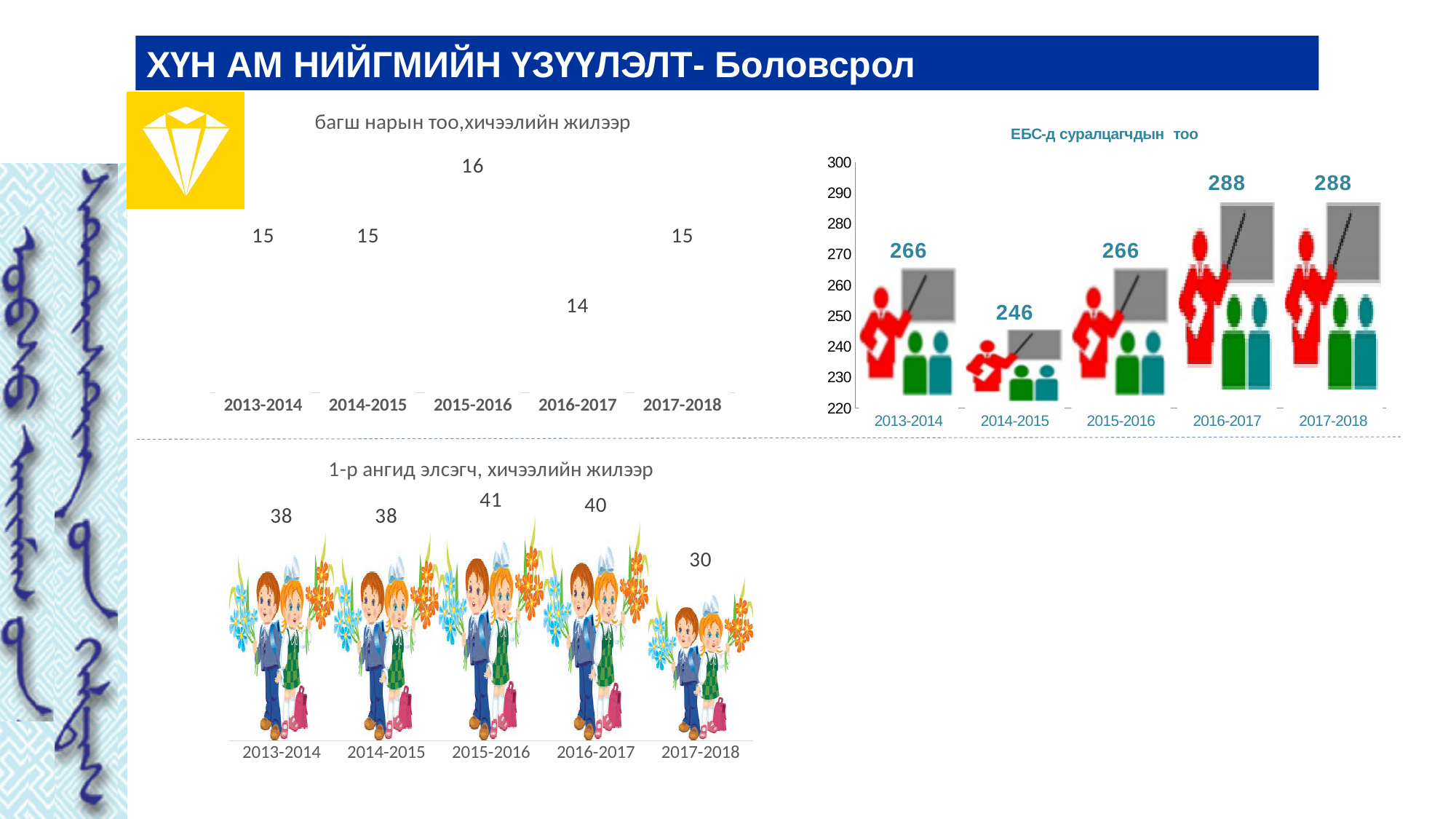
In the chart titled "багш нарын тоо,хичээлийн жилээр", what is the value for 2015-2016? 16 In the chart titled "ЕБС-д суралцагчдын тоо", is the value for 2015-2016 greater or less than 250? greater In the chart titled "ЕБС-д суралцагчдын тоо", how many school years are shown on the x axis? 5 In the chart titled "1-р ангид элсэгч, хичээлийн жилээр", which is larger, the value for 2016-2017 or the value for 2017-2018? 2016-2017 In the chart titled "ЕБС-д суралцагчдын тоо", what is the value for 2014-2015? 246 In the chart titled "ЕБС-д суралцагчдын тоо", what is the difference between the values for 2016-2017 and 2013-2014? 22 In the chart titled "1-р ангид элсэгч, хичээлийн жилээр", what is the difference between the values for 2015-2016 and 2017-2018? 11 In the chart titled "1-р ангид элсэгч, хичээлийн жилээр", which school year has the highest value? 2015-2016 In the chart titled "1-р ангид элсэгч, хичээлийн жилээр", what is the value for 2017-2018? 30 In the chart titled "ЕБС-д суралцагчдын тоо", which school year has the lowest value? 2014-2015 In the chart titled "багш нарын тоо,хичээлийн жилээр", what is the difference between the values for 2015-2016 and 2016-2017? 2 In the chart titled "багш нарын тоо,хичээлийн жилээр", which school year has the lowest value? 2016-2017